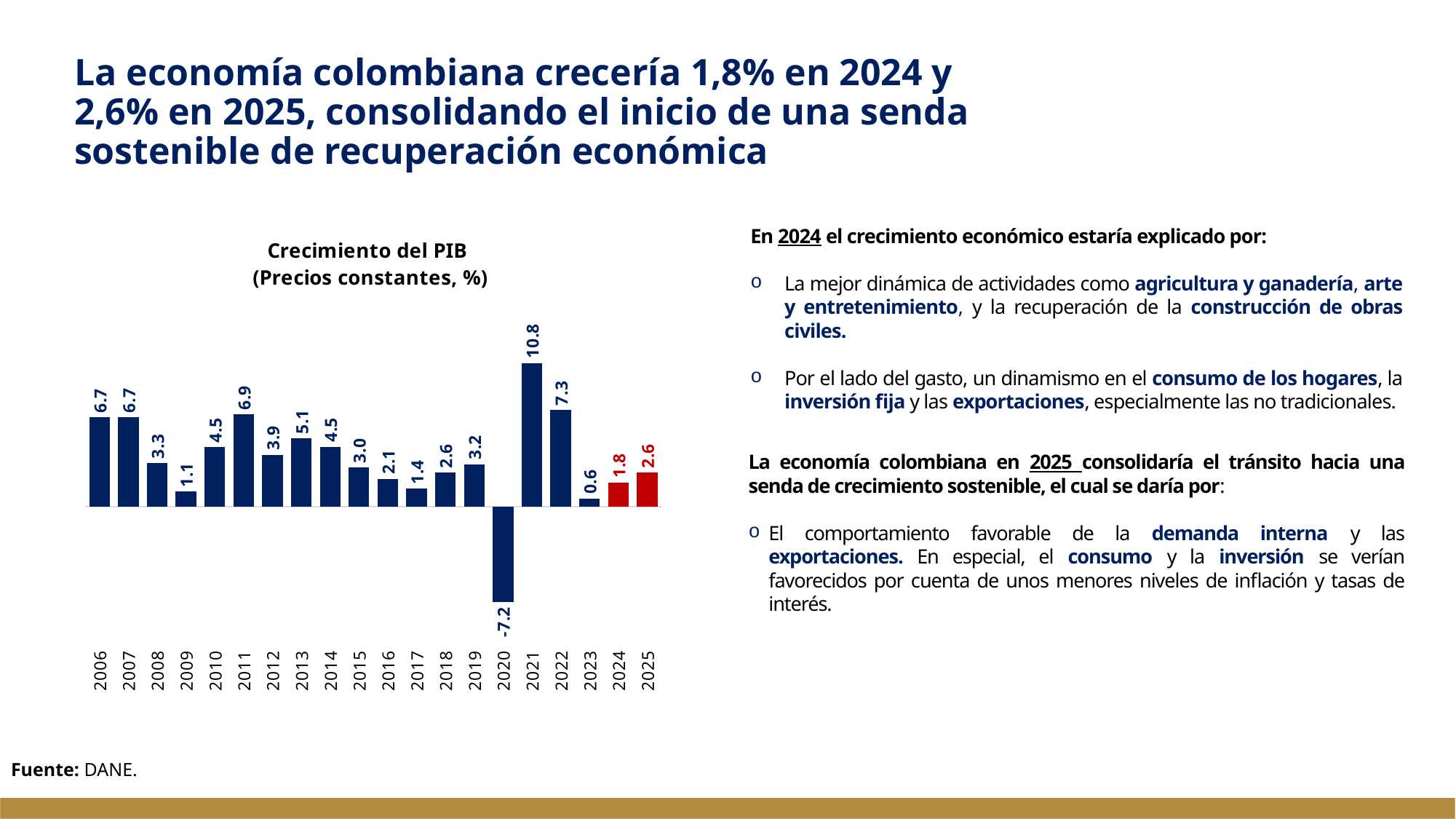
Which year has the lowest GDP growth in the chart? 2020 What type of chart is used to show GDP growth? Bar chart What is the GDP growth value shown for 2021? 10.8 Do the GDP growth values rise or fall from 2021 to 2023? Fall Which years are shown with red bars in the chart? 2024 and 2025 What is the difference between the GDP growth values for 2021 and 2022? 3.5 How many years are shown on the x axis of the chart? 20 What is the title of the chart? Crecimiento del PIB (Precios constantes, %) What is the GDP growth value shown for 2024? 1.8 Which year has a higher GDP growth value, 2011 or 2013? 2011 Which year has the highest GDP growth in the chart? 2021 What is the GDP growth value shown for 2020? -7.2